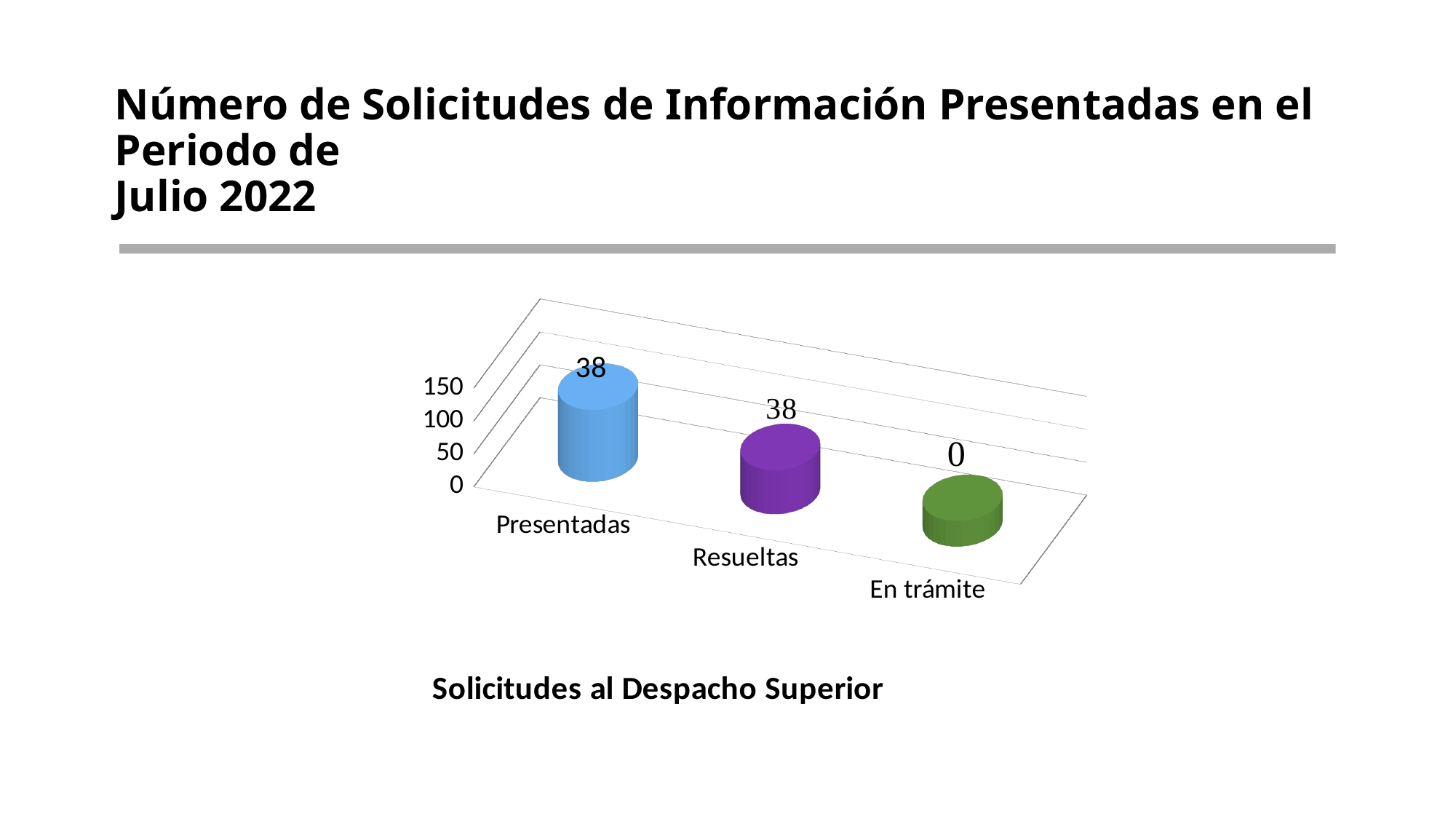
Is the value for Resueltas greater or less than 100? less How many categories are shown on the chart? 3 What colour is the bar for Resueltas? purple Which category has the lowest value? En trámite What kind of chart is shown on the slide? bar chart What is the title shown below the chart? Solicitudes al Despacho Superior